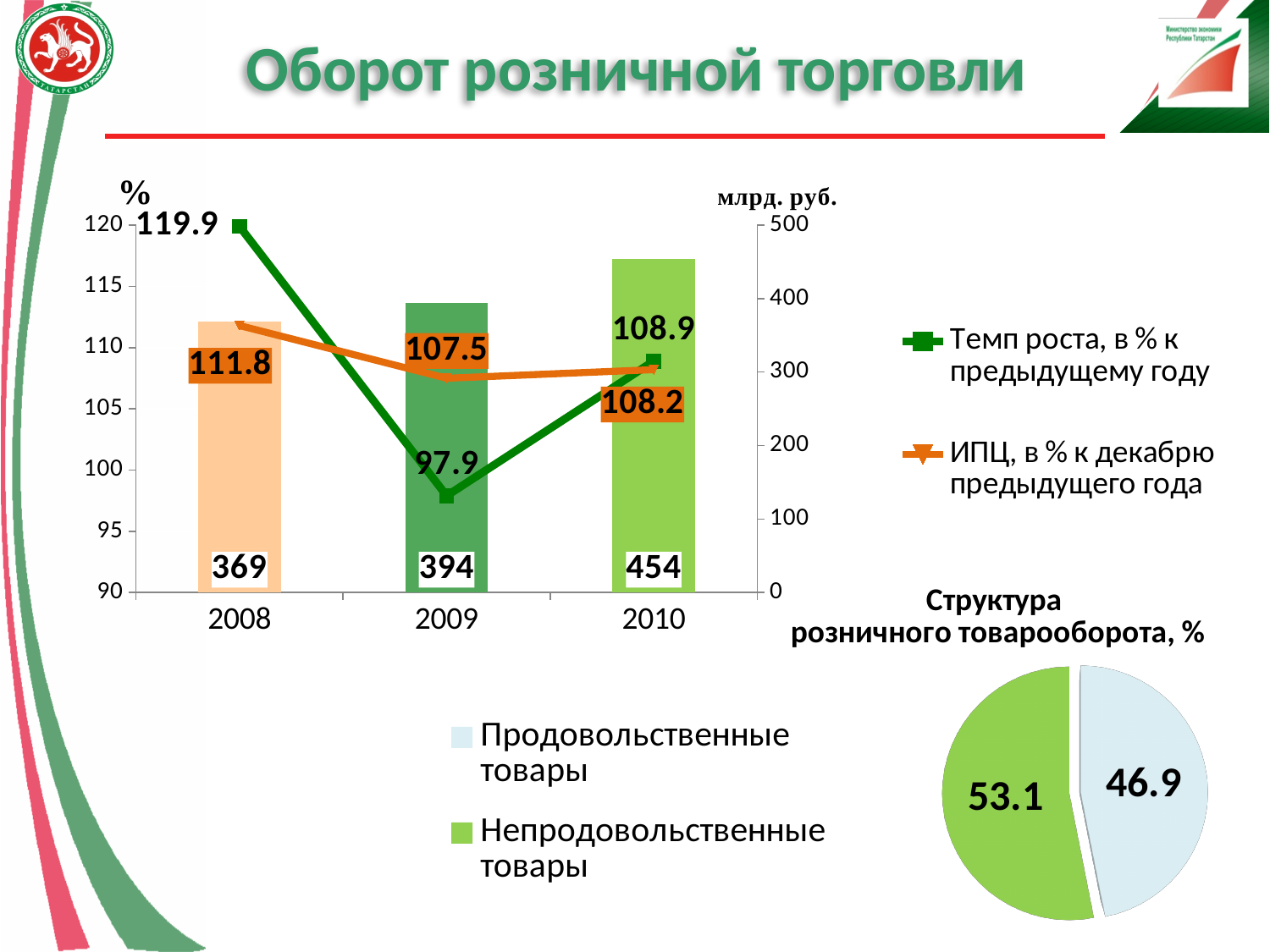
In the left chart, how many years are shown on the x axis? 3 In the left chart, which year has the highest bar value? 2010 In the left chart, how many line series does the legend list? 2 In the left chart, what is the value of 'Темп роста, в % к предыдущему году' for 2009? 97.9 What kind of chart is 'Структура розничного товарооборота, %'? pie chart In the left chart, do the bar values rise or fall from 2008 to 2010? rise In the left chart, what is the retail turnover value (млрд. руб.) shown on the bar for 2010? 454 In the left chart, which year has the lowest value for 'Темп роста, в % к предыдущему году'? 2009 In the left chart, what is the value of 'ИПЦ, в % к декабрю предыдущего года' for 2008? 111.8 In the left chart, what is the difference between the bar values for 2010 and 2008? 85 In the left chart, which is larger for 2010: 'Темп роста' or 'ИПЦ'? Темп роста In the chart 'Структура розничного товарооборота, %', what is the share of 'Непродовольственные товары'? 53.1